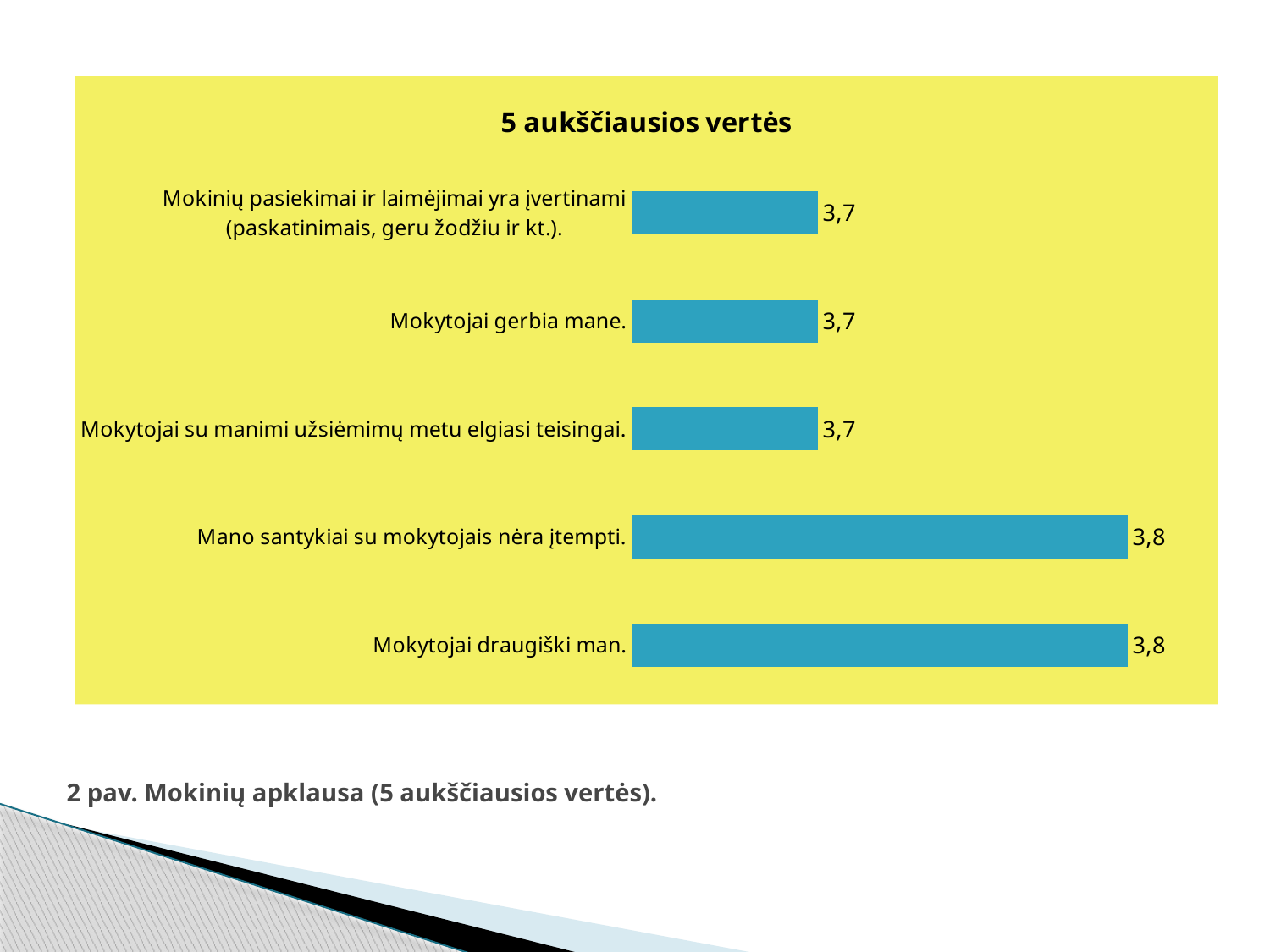
What is the difference between the value for "Mano santykiai su mokytojais nėra įtempti." and the value for "Mokytojai su manimi užsiėmimų metu elgiasi teisingai."? 0,1 What is the value for "Mokytojai draugiški man."? 3,8 What is the value for "Mano santykiai su mokytojais nėra įtempti."? 3,8 Which is larger, the value for "Mokytojai draugiški man." or the value for "Mokytojai gerbia mane."? Mokytojai draugiški man. What is the title of the chart? 5 aukščiausios vertės How many categories are shown in the chart? 5 What colour are the bars in the chart? Blue What is the value for "Mokytojai su manimi užsiėmimų metu elgiasi teisingai."? 3,7 What is the value for "Mokytojai gerbia mane."? 3,7 How many categories have a value of 3,8? 2 What is the value for "Mokinių pasiekimai ir laimėjimai yra įvertinami (paskatinimais, geru žodžiu ir kt.)."? 3,7 What kind of chart is shown on the slide? Bar chart